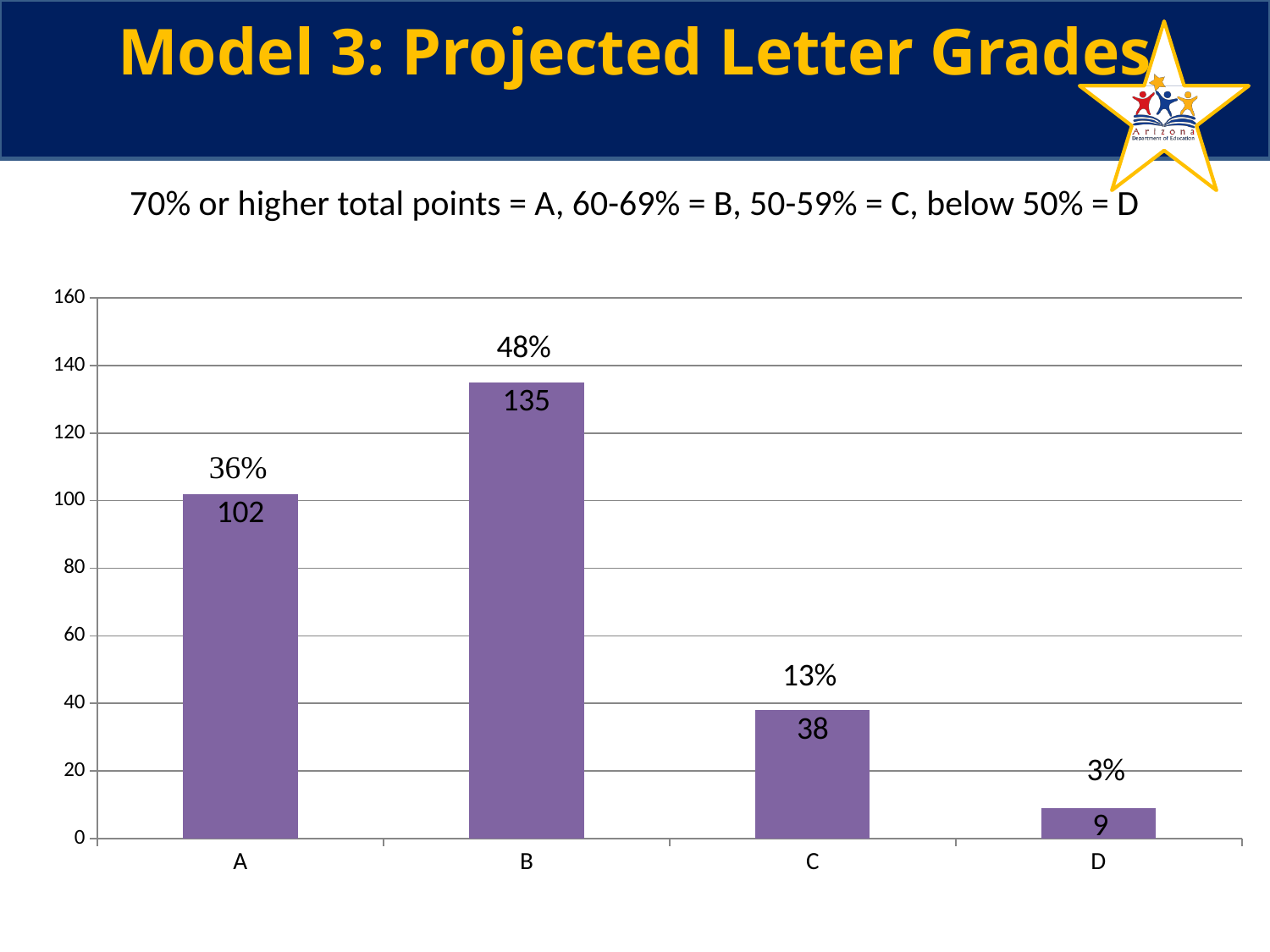
What is the difference between the values for grade B and grade A? 33 What kind of chart is shown on the slide? bar chart Is the value for grade C greater or less than 40? less Which letter grade has the highest value? B How many letter grade categories are shown on the x axis? 4 What is the title of the slide containing the chart? Model 3: Projected Letter Grades What percentage is shown above the bar for grade A? 36% What is the value for grade D? 9 What percentage is shown above the bar for grade C? 13% What is the value for grade B? 135 Which letter grade has the lowest value? D Which is larger, the value for grade A or the value for grade C? A